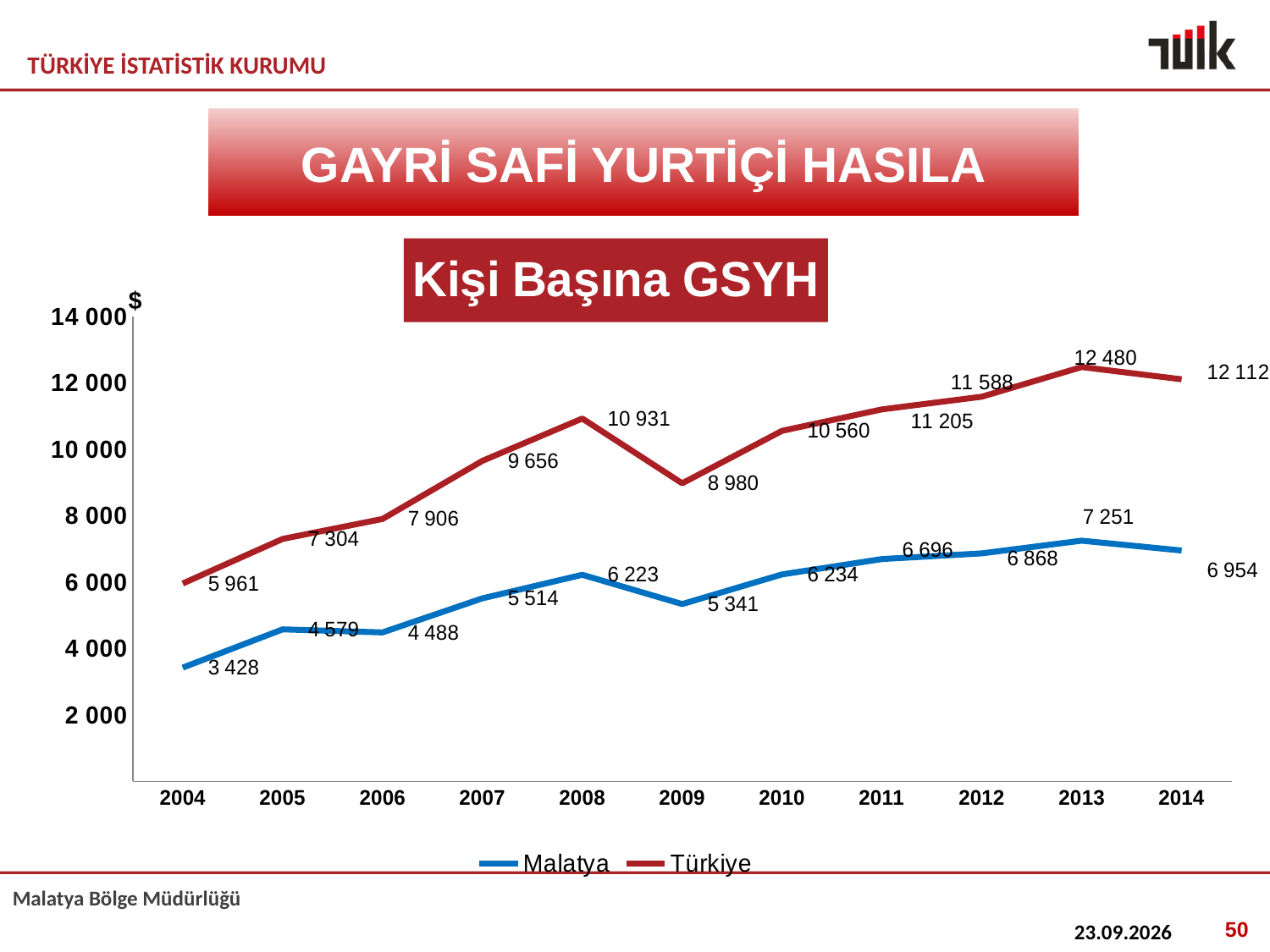
Which is larger, the Malatya value in 2008 or the Malatya value in 2009? 2008 What is the difference between the Türkiye and Malatya values in 2013? 5 229 Does the Türkiye series rise or fall from 2008 to 2009? Fall What kind of chart is shown on the slide? Line chart In which year is the Türkiye series highest? 2013 What is the title shown above the chart? Kişi Başına GSYH How many series does the legend list? 2 What is the value for Malatya in 2014? 6 954 In which year is the Malatya series lowest? 2004 How many years are shown on the x axis? 11 What is the value for Malatya in 2004? 3 428 What is the value for Türkiye in 2008? 10 931